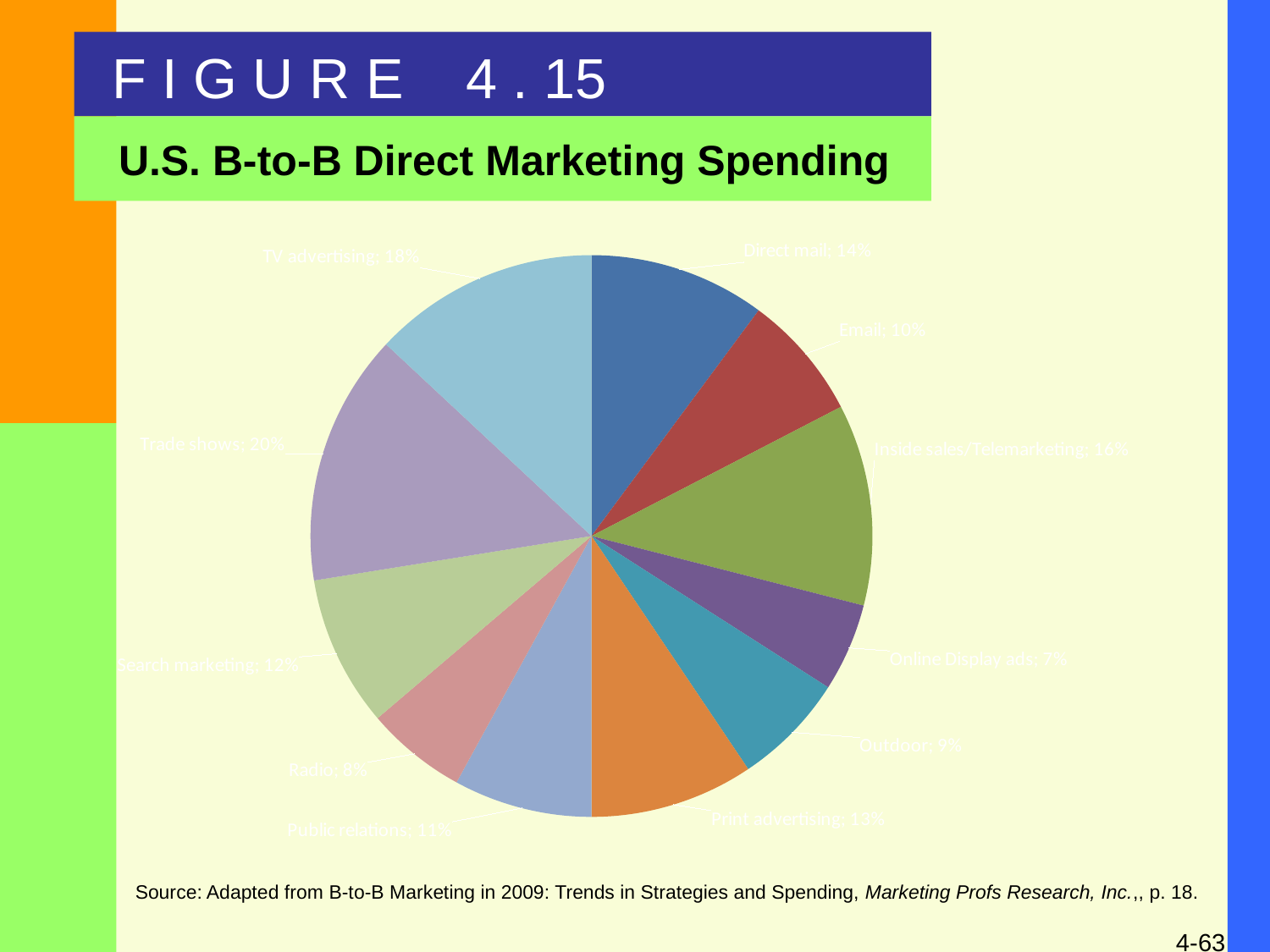
What is the difference between the values for Search marketing and Email? 2% Which is larger, the value for Print advertising or the value for Public relations? Print advertising Which category has the smallest slice of the pie? Online Display ads What is the value shown for Direct mail? 14% What is the difference between the values for TV advertising and Radio? 10% What is the value shown for Online Display ads? 7% How many slices does the pie chart have? 11 Which category has the largest slice of the pie? Trade shows What is the value shown for Trade shows? 20% What is the value shown for Inside sales/Telemarketing? 16% What kind of chart is shown on the slide? pie chart What is the title of the chart on the slide? U.S. B-to-B Direct Marketing Spending